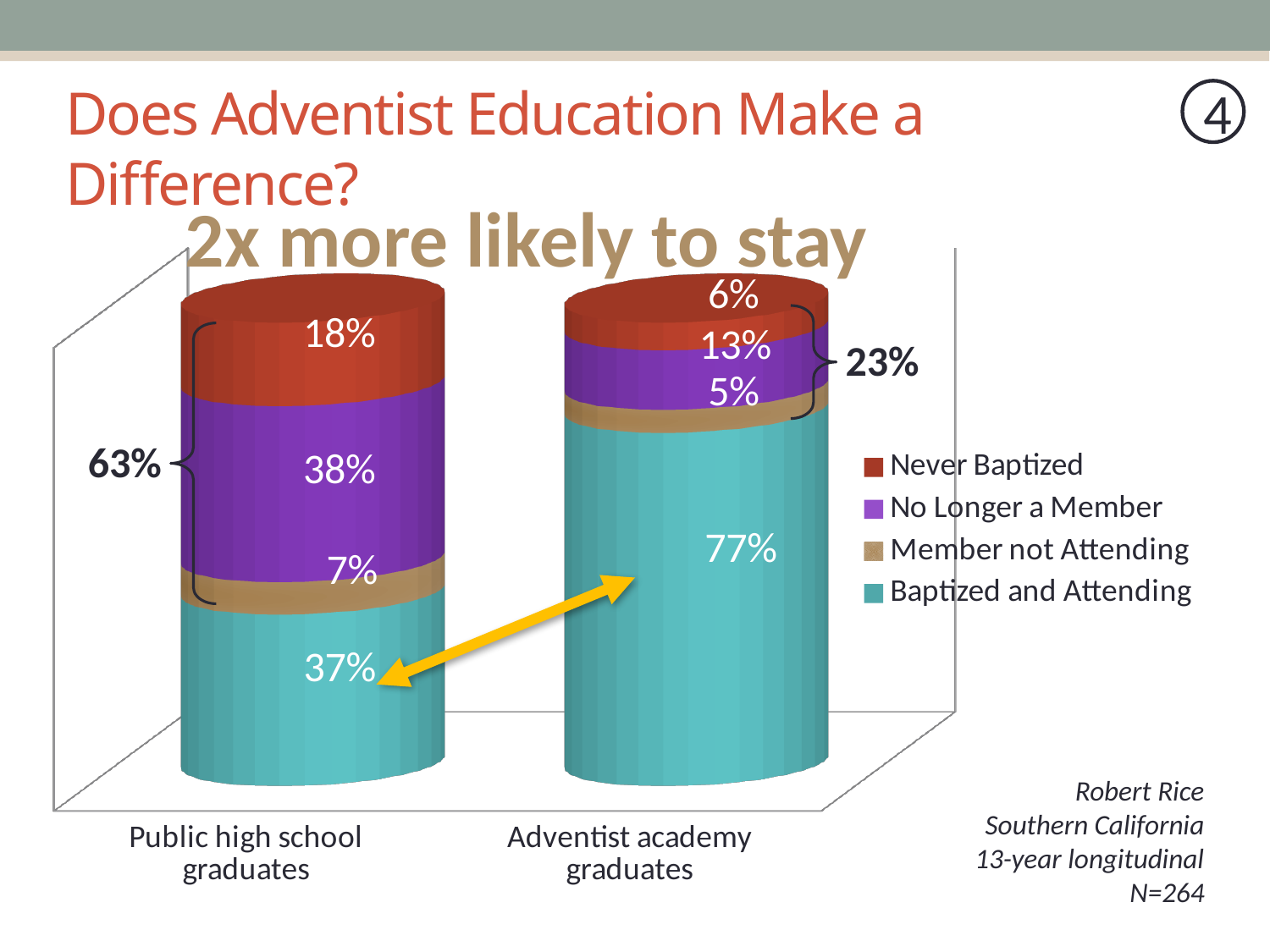
What kind of chart is shown on the slide? Stacked bar chart Which segment is the largest for Public high school graduates? No Longer a Member Which category has the higher Baptized and Attending value? Adventist academy graduates What is the difference in the No Longer a Member value between Public high school graduates and Adventist academy graduates? 25% What is the Member not Attending value for Public high school graduates? 7% What percentage of Adventist academy graduates are Baptized and Attending? 77% How many series does the legend list? 4 Which segment is the smallest for Adventist academy graduates? Member not Attending What is the No Longer a Member value for Adventist academy graduates? 13% What is the Never Baptized value for Public high school graduates? 18% What percentage of Public high school graduates are Baptized and Attending? 37% What is the difference in the Baptized and Attending value between Adventist academy graduates and Public high school graduates? 40%